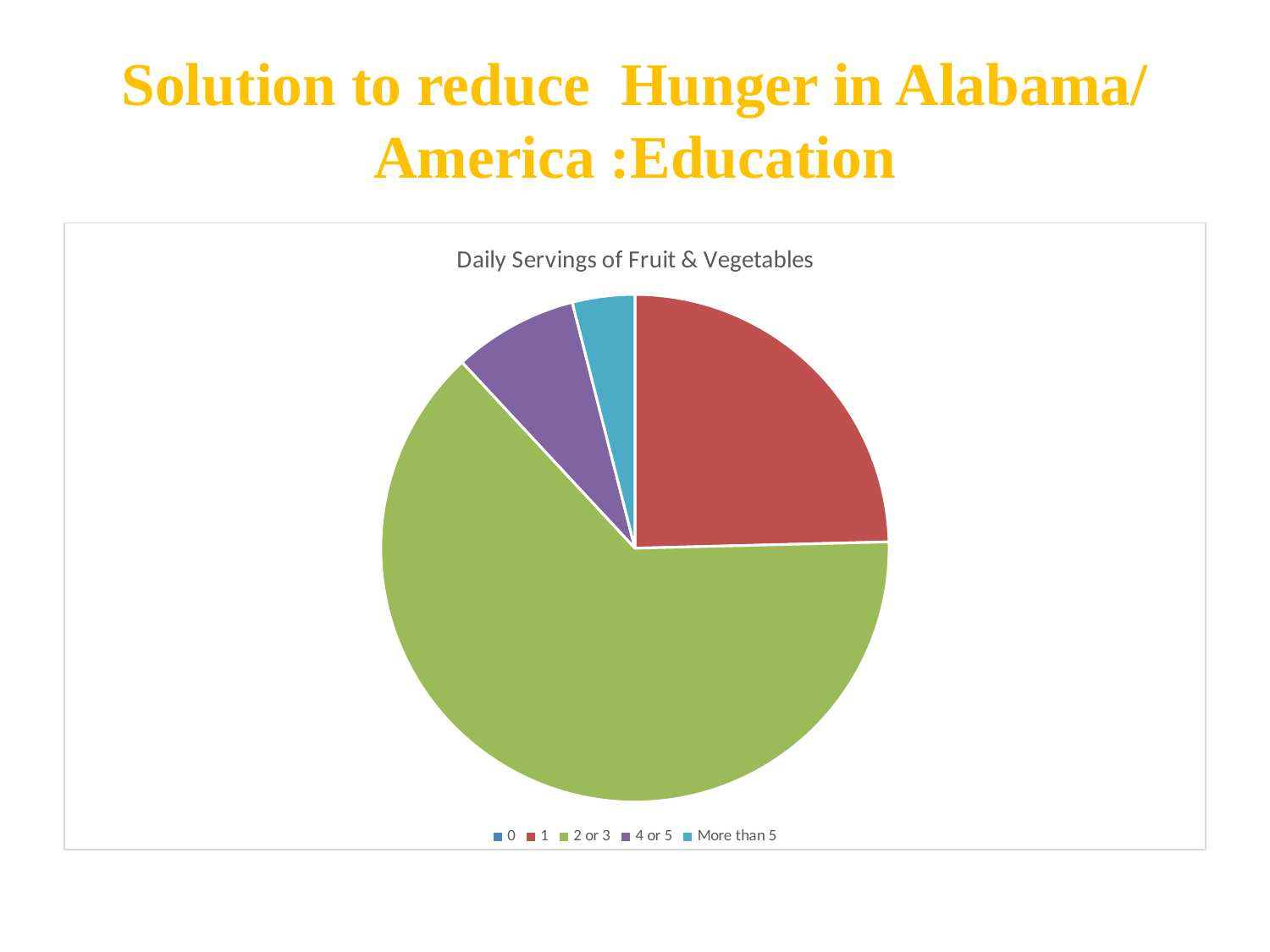
How many categories does the chart's legend list? 5 What is the title of the chart? Daily Servings of Fruit & Vegetables What colour is the slice for '2 or 3'? green What kind of chart is shown on the slide? pie chart Which slice is larger, '1' or '4 or 5'? 1 Which slice is larger, 'More than 5' or '1'? 1 Does the '2 or 3' slice take up more or less than half of the pie? more Which slice is larger, '2 or 3' or '1'? 2 or 3 Which category has the largest slice of the pie? 2 or 3 How many slices are visibly drawn in the pie? 4